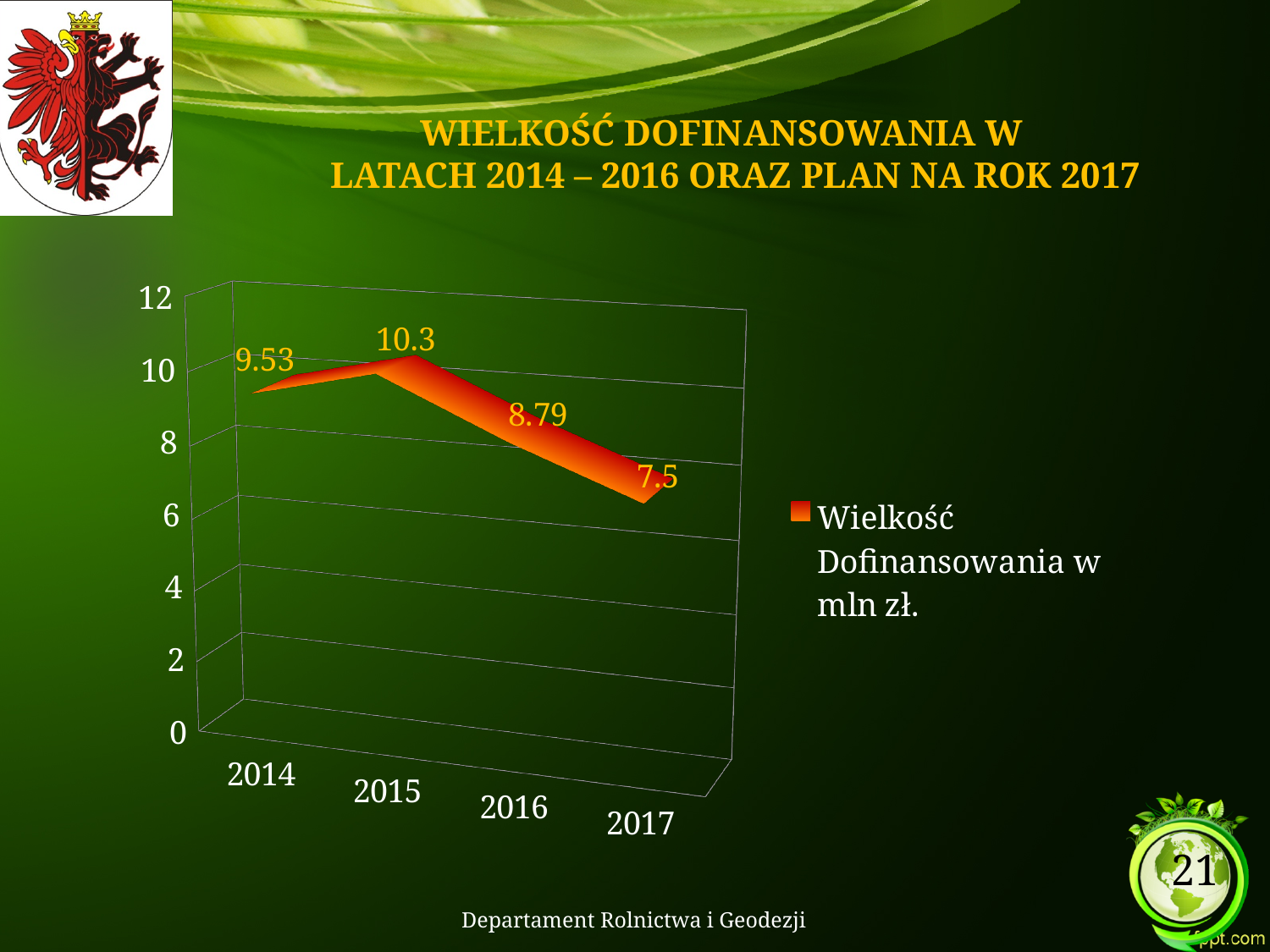
What is the value for 2016? 8.79 What is the value for 2014? 9.53 What is the difference between the values for 2015 and 2017? 2.8 What kind of chart is shown? line chart What is the value for 2017? 7.5 Do the values rise or fall from 2015 to 2017? fall Which year has the lowest value? 2017 How many years are shown on the x axis? 4 Which year has the highest value? 2015 How many series does the legend list? 1 Which is larger, the value for 2014 or the value for 2016? 2014 What is the value for 2015? 10.3